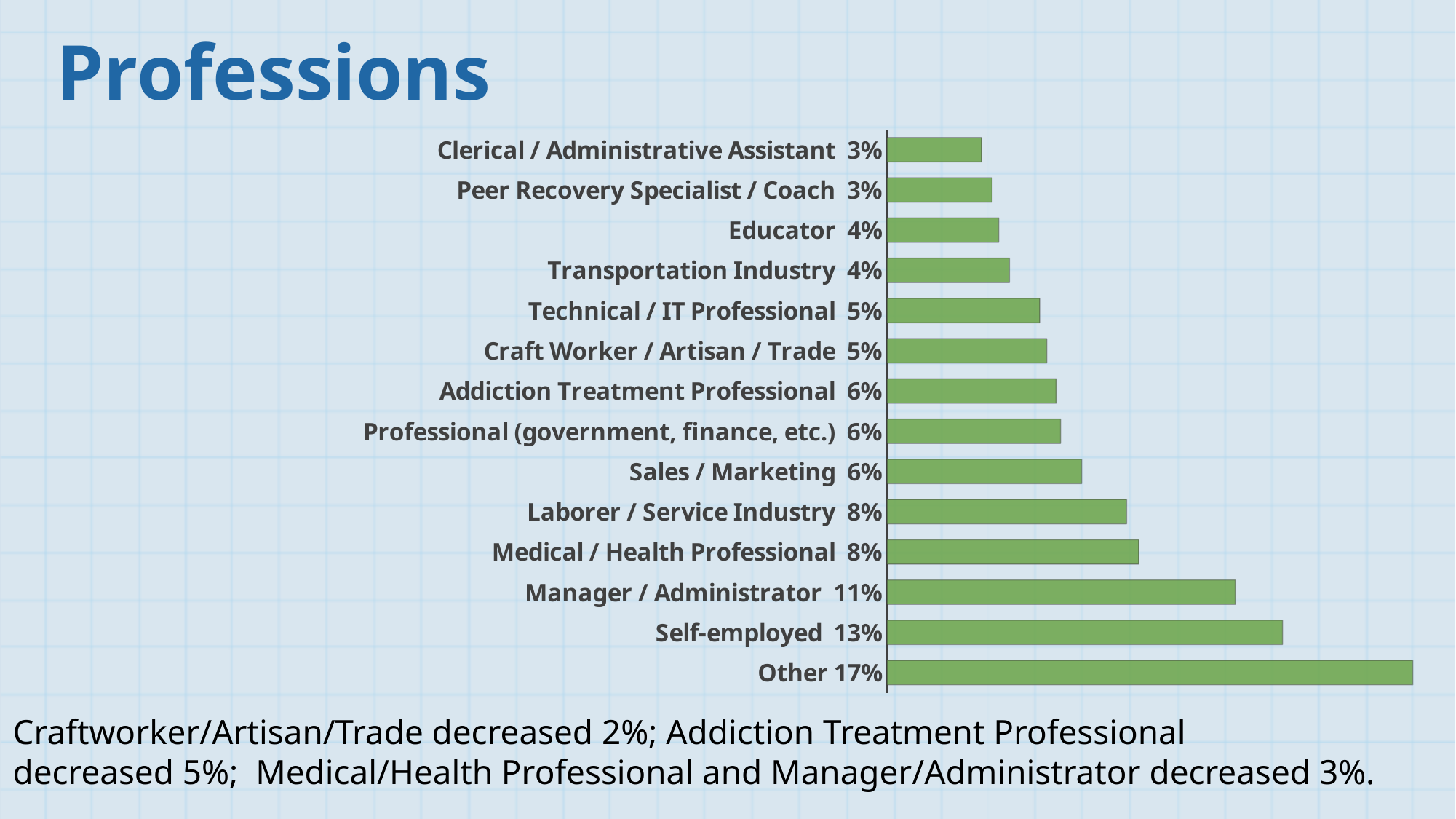
Which is larger, the value for Self-employed or the value for Laborer / Service Industry? Self-employed What is the difference in percentage points between Manager / Administrator and Medical / Health Professional? 3 What percentage is shown for Educator? 4% What percentage is shown for Laborer / Service Industry? 8% What percentage is shown for Self-employed? 13% Which category has the highest percentage? Other How many profession categories are shown in the chart? 14 What percentage is shown for Manager / Administrator? 11% What is the difference in percentage points between Other and Self-employed? 4 What kind of chart is shown on the slide? Bar chart Which is larger, the value for Sales / Marketing or the value for Technical / IT Professional? Sales / Marketing What is the title of the slide? Professions